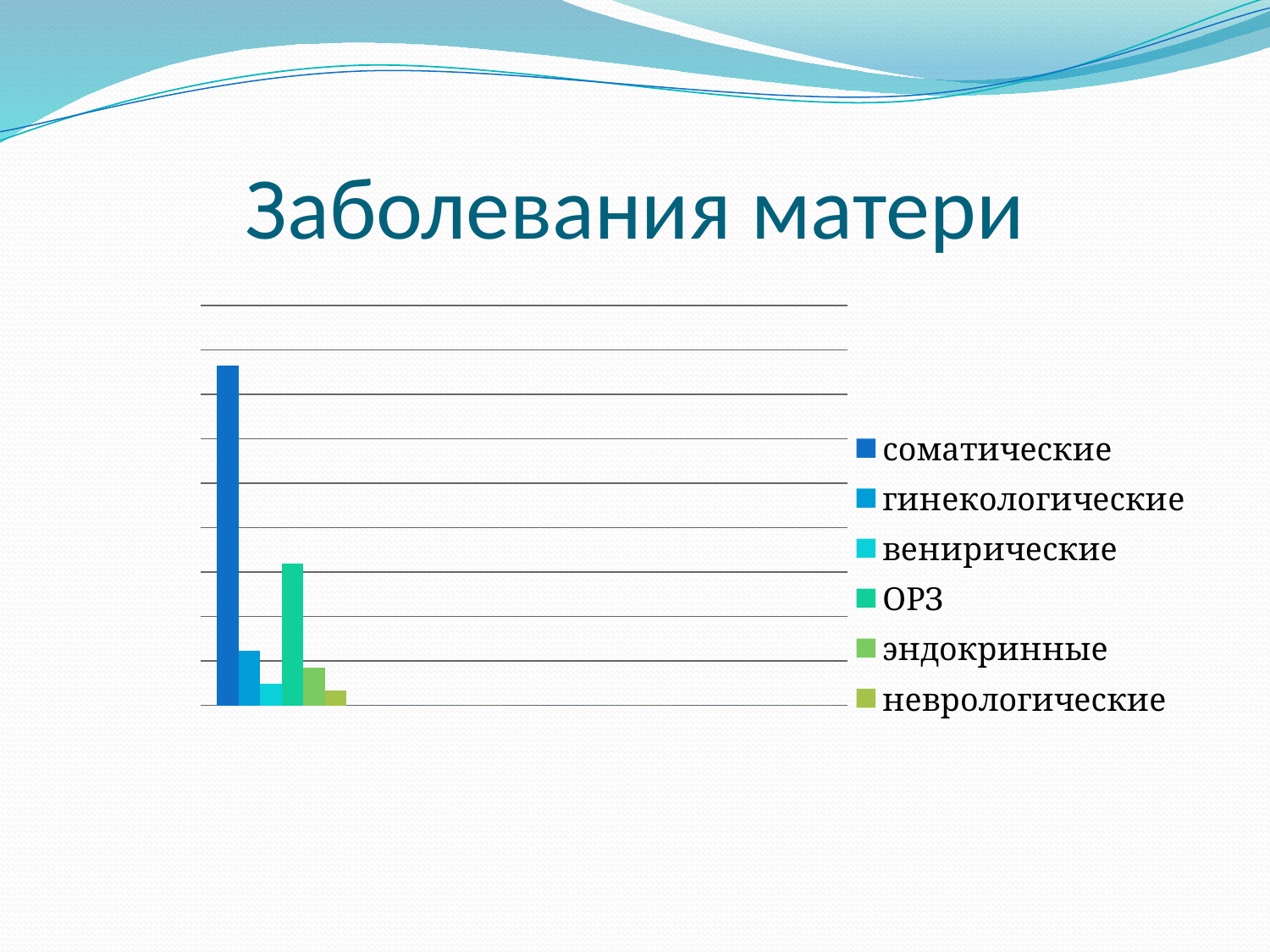
Which is larger, the bar for эндокринные or the bar for неврологические? эндокринные What is the title of the slide? Заболевания матери What kind of chart is shown on the slide? bar chart Which series has the lowest bar? неврологические Which is larger, the bar for гинекологические or the bar for венирические? гинекологические Which is larger, the bar for соматические or the bar for ОРЗ? соматические How many series does the legend list? 6 Which legend entry is listed last? неврологические Which series has the second highest bar? ОРЗ Which series has the highest bar? соматические